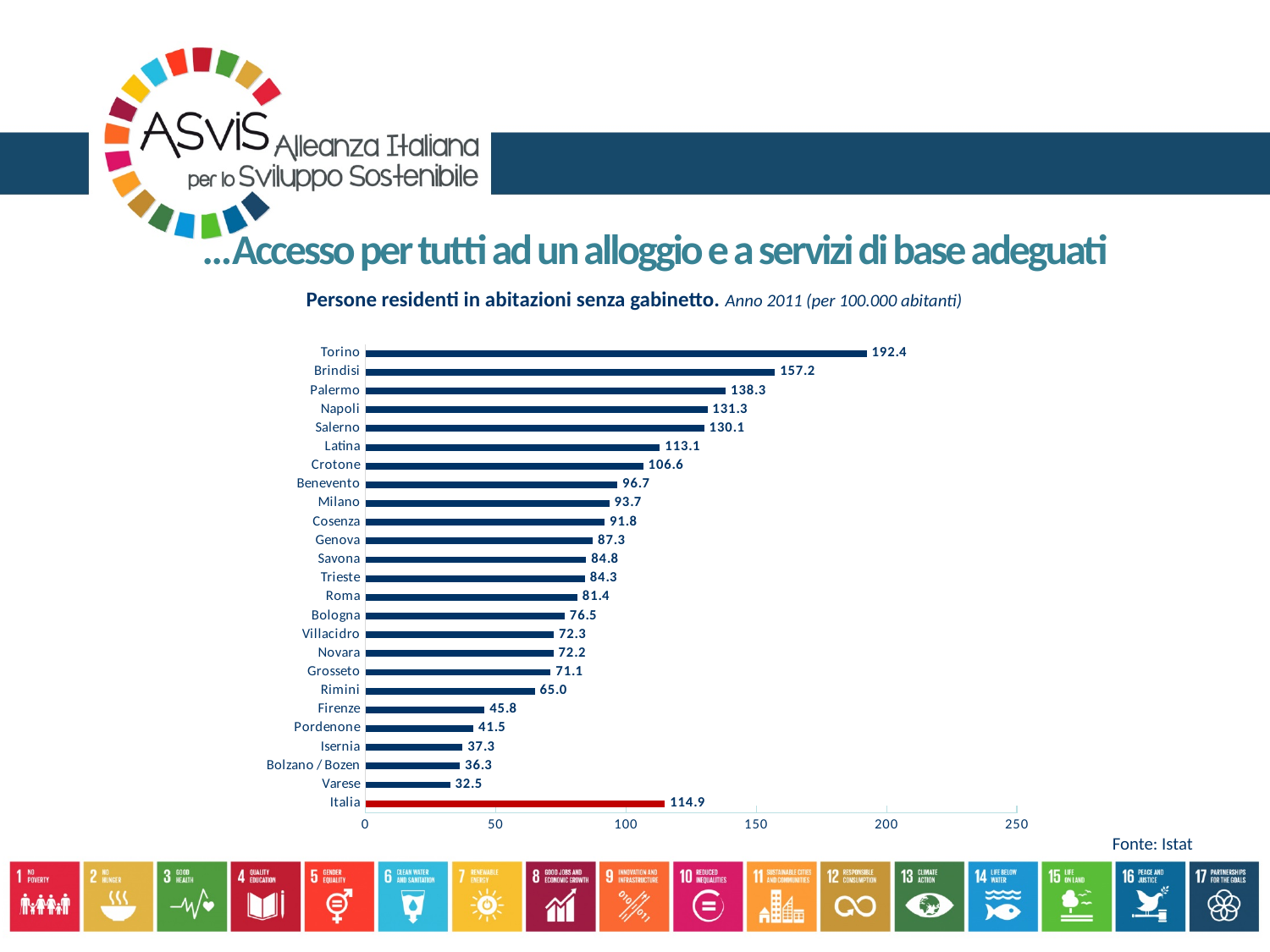
Which city has the lowest value? Varese Which has a larger value, Milano or Roma? Milano What is the difference between the values for Torino and Brindisi? 35.2 What is the source cited for the chart? Istat What is the value for Bolzano / Bozen? 36.3 What kind of chart is shown on the slide? Bar chart Is the value for Latina greater or less than 100? greater How many categories (bars) are shown in the chart? 25 What is the value for Italia? 114.9 What is the value for Torino? 192.4 What is the difference between the value for Italia and the value for Firenze? 69.1 Which city has the highest value? Torino